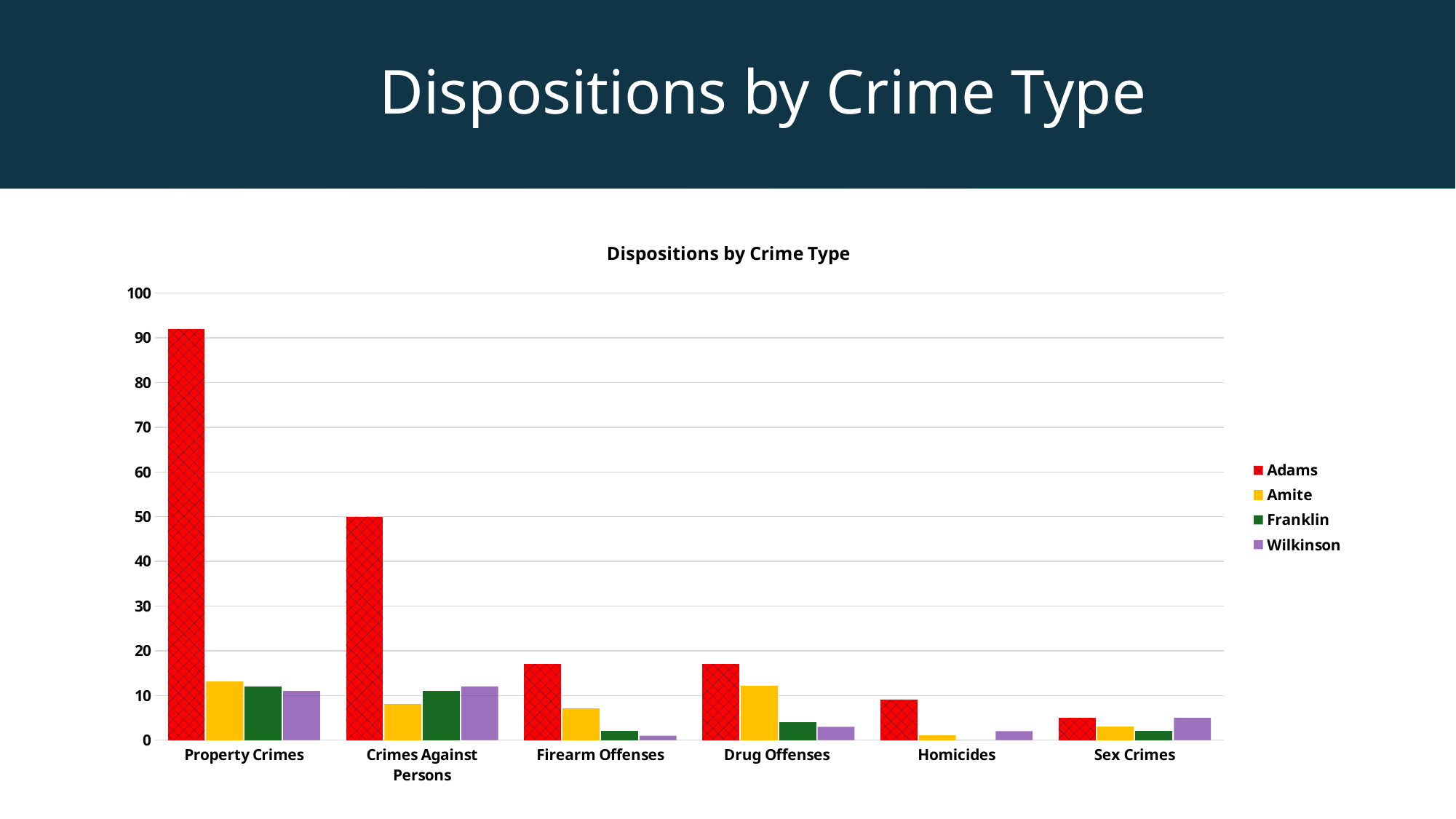
Is the Franklin value for Drug Offenses greater or less than 10? less Which series is shown in red in the legend? Adams Is the Adams value for Crimes Against Persons greater or less than 60? less For Property Crimes, which is larger: the Adams value or the Amite value? Adams What is the title of the chart? Dispositions by Crime Type What kind of chart is shown on the slide? bar chart Is the Adams value for Property Crimes greater or less than 80? greater For which crime type is the Adams value highest? Property Crimes How many crime type categories are shown on the x axis? 6 For Sex Crimes, which is larger: the Wilkinson value or the Franklin value? Wilkinson How many series does the legend list? 4